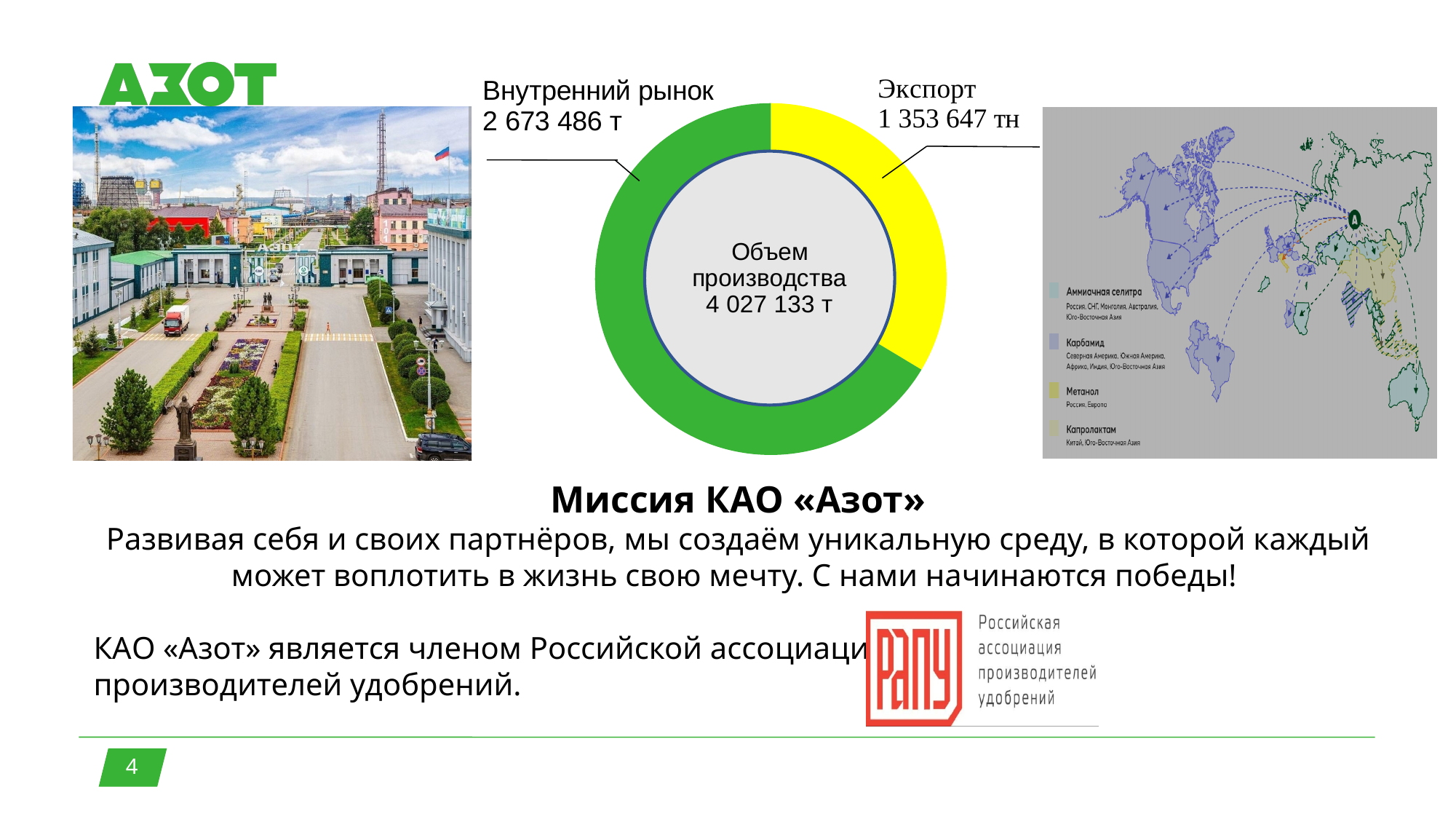
What colour is the Внутренний рынок segment of the doughnut chart? Green What kind of chart is used to show the split between Внутренний рынок and Экспорт? Doughnut (pie) chart What colour is the Экспорт segment of the doughnut chart? Yellow How many segments does the doughnut chart have? 2 What total production volume (Объем производства) is shown in the centre of the doughnut chart? 4 027 133 т What is the value shown for Экспорт on the doughnut chart? 1 353 647 тн Which category has the lowest value on the doughnut chart? Экспорт Which segment of the doughnut chart is larger, Внутренний рынок or Экспорт? Внутренний рынок What is the value shown for Внутренний рынок on the doughnut chart? 2 673 486 т Which category has the highest value on the doughnut chart? Внутренний рынок By how much does Внутренний рынок exceed Экспорт on the doughnut chart? 1 319 839